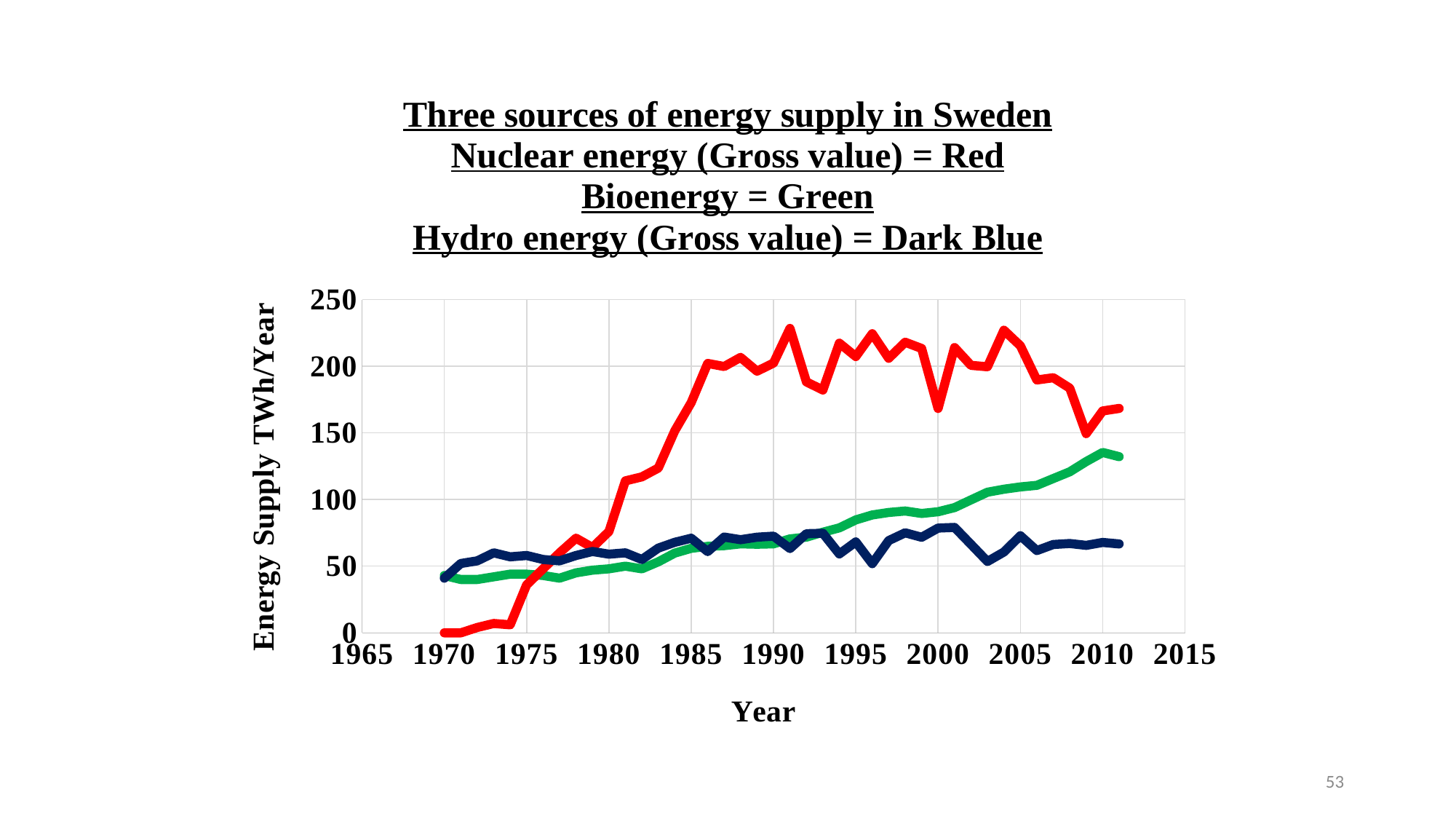
In 2010, which is larger: Bioenergy or Hydro energy? Bioenergy How many energy sources (series) are plotted on the chart? 3 What is the label of the y axis? Energy Supply TWh/Year Which colour represents Bioenergy on the chart? Green Is the value for Nuclear energy in 2005 greater or less than 200? greater Which energy source has the highest value in 2000? Nuclear energy Is the value for Hydro energy in 2010 greater or less than 100? less Is the value for Nuclear energy in 1975 greater or less than 50? less What kind of chart is shown on the slide? line chart Does the Bioenergy line generally rise or fall from 1970 to 2010? rise